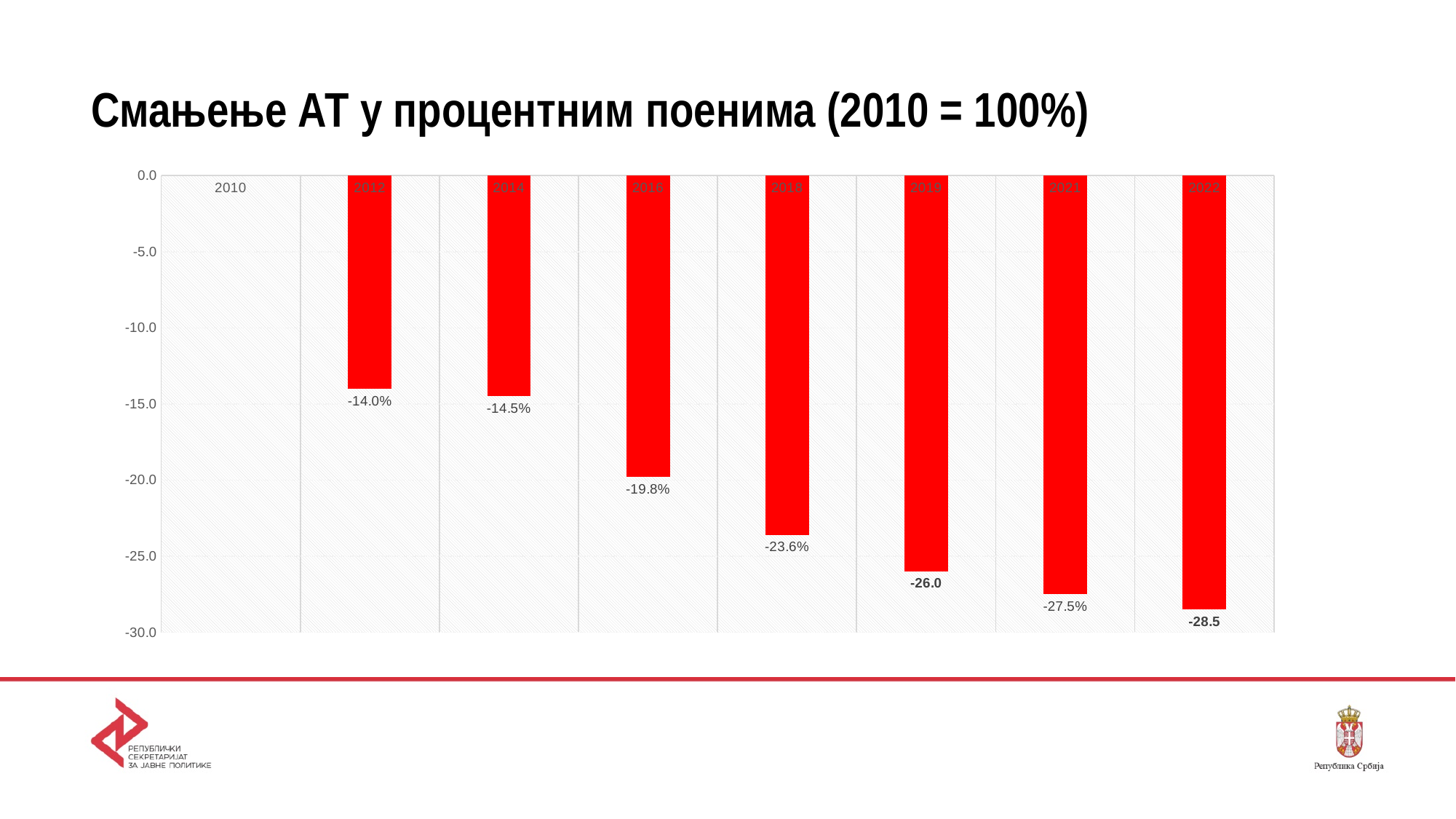
What kind of chart is this? bar chart Is the value for 2019 greater or less than -25.0? less What is the value shown for 2018? -23.6% What is the value shown for 2022? -28.5 What is the value shown for 2012? -14.0% Do the values rise or fall from 2012 to 2022? fall What is the value shown for 2016? -19.8% What is the difference between the values for 2012 and 2014? 0.5% Which year has the smallest reduction among the years with a bar? 2012 How many year categories are shown on the x axis? 8 Which year has the lowest (most negative) value? 2022 Which is more negative, the value for 2018 or the value for 2021? 2021